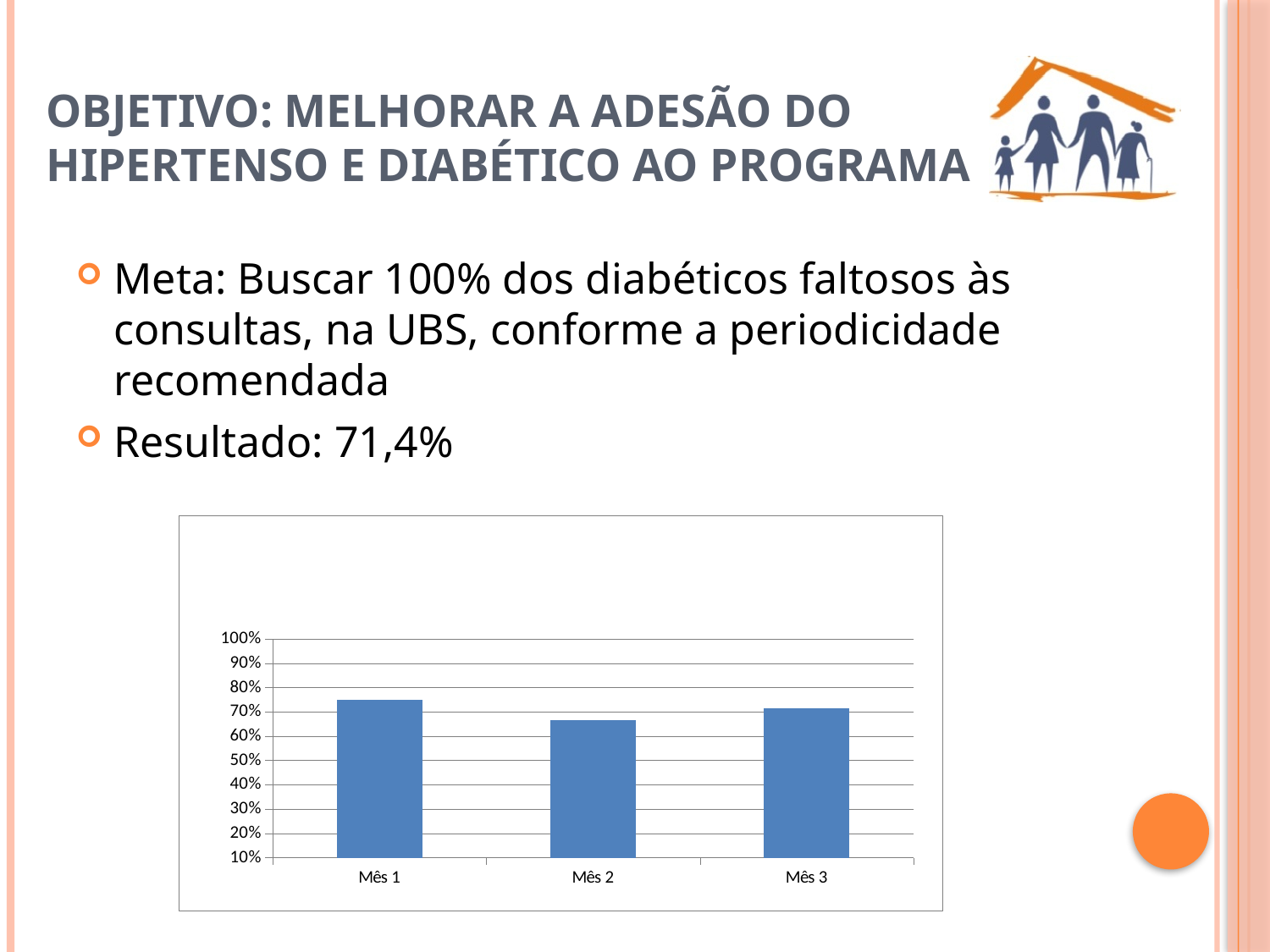
Is the value for Mês 1 greater or less than 70%? greater How many categories (months) are plotted in the chart? 3 Is the value for Mês 2 greater or less than 70%? less Which month has the lowest bar in the chart? Mês 2 Is the value for Mês 2 greater or less than 60%? greater Which is larger, the value for Mês 1 or the value for Mês 2? Mês 1 What kind of chart is shown on the slide? bar chart Which is larger, the value for Mês 2 or the value for Mês 3? Mês 3 Which month has the highest bar in the chart? Mês 1 Do the values rise or fall from Mês 1 to Mês 2? fall What is the highest value shown on the vertical axis of the chart? 100%